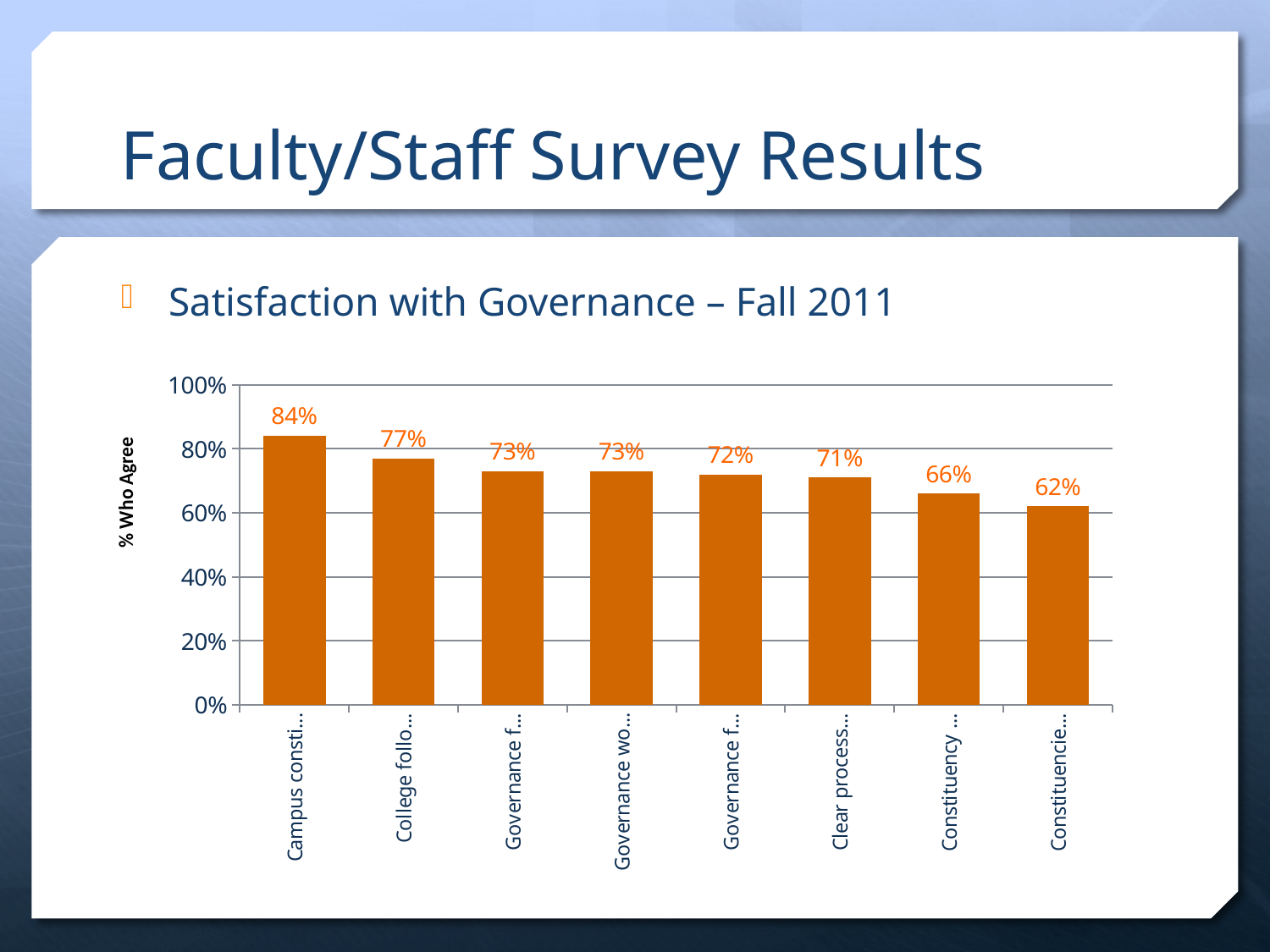
What is the label on the vertical axis? % Who Agree Do the bar values generally rise or fall from left to right? fall Which bar has the lowest value? Constituencie... (rightmost bar) What is the value of the rightmost bar (Constituencie...)? 62% How many bars are plotted in the chart? 8 What is the value of the bar labelled Clear process...? 71% What is the difference between the highest bar (84%) and the lowest bar (62%)? 22% What is the value of the second bar from the left (College follo...)? 77% What is the value of the leftmost bar (Campus consti...)? 84% Which bar has the highest value? Campus consti... (leftmost bar) Which is larger, the value for College follo... or the value for Constituency ...? College follo... What type of chart is shown on the slide? bar chart